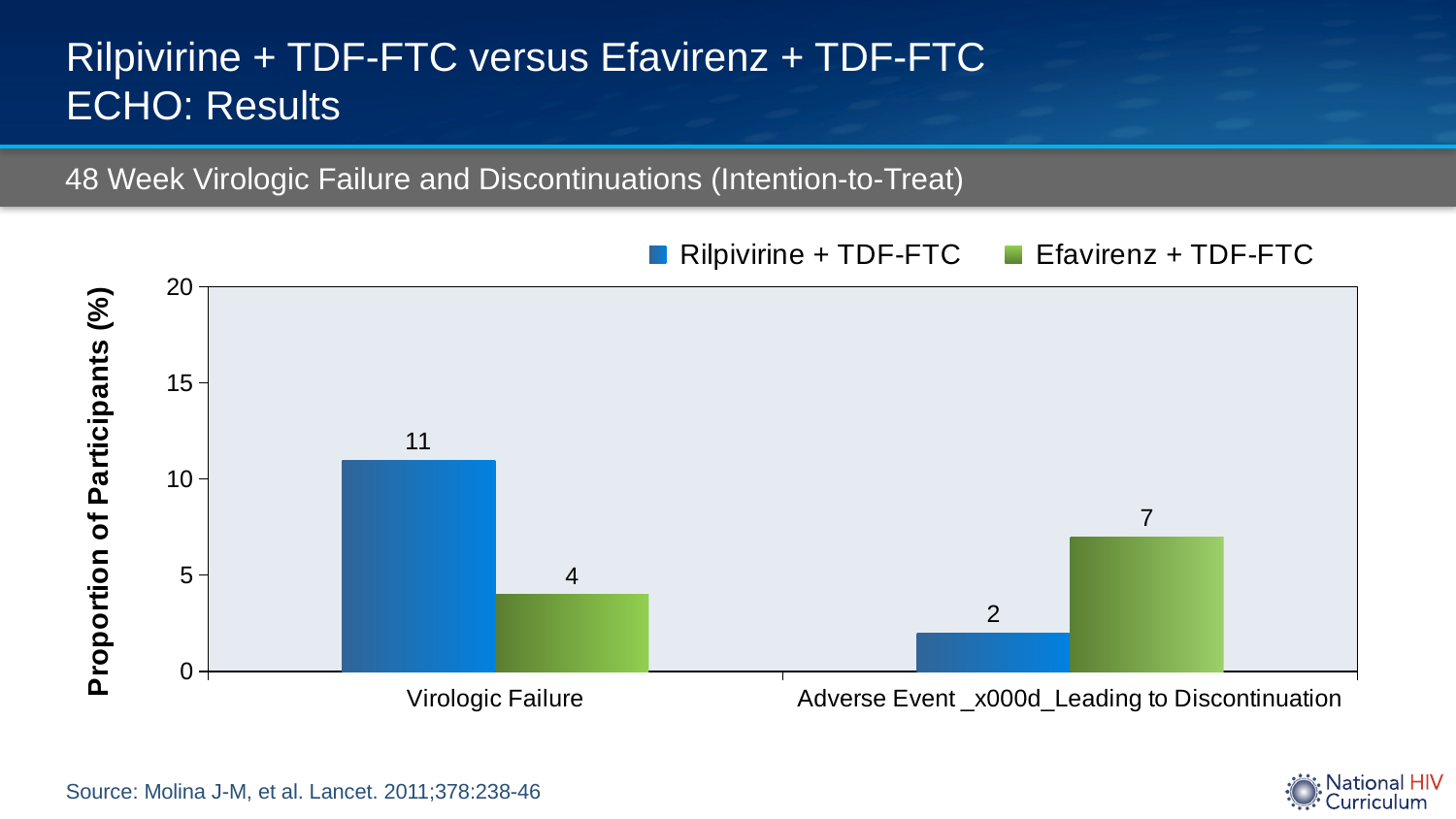
What is the value for Efavirenz + TDF-FTC in the Virologic Failure category? 4 What is the value for Rilpivirine + TDF-FTC in the Adverse Event Leading to Discontinuation category? 2 Which is larger: the Efavirenz + TDF-FTC value for Virologic Failure or the Efavirenz + TDF-FTC value for Adverse Event Leading to Discontinuation? Adverse Event Leading to Discontinuation Which series has the highest value in the Virologic Failure category? Rilpivirine + TDF-FTC What is the value for Rilpivirine + TDF-FTC in the Virologic Failure category? 11 What is the difference between the Rilpivirine + TDF-FTC and Efavirenz + TDF-FTC values for Virologic Failure? 7 Which series has the lowest value in the Adverse Event Leading to Discontinuation category? Rilpivirine + TDF-FTC What is the label of the y axis? Proportion of Participants (%) What is the value for Efavirenz + TDF-FTC in the Adverse Event Leading to Discontinuation category? 7 How many series does the legend list? 2 What is the difference between the Efavirenz + TDF-FTC and Rilpivirine + TDF-FTC values for Adverse Event Leading to Discontinuation? 5 What kind of chart is shown on the slide? Bar chart